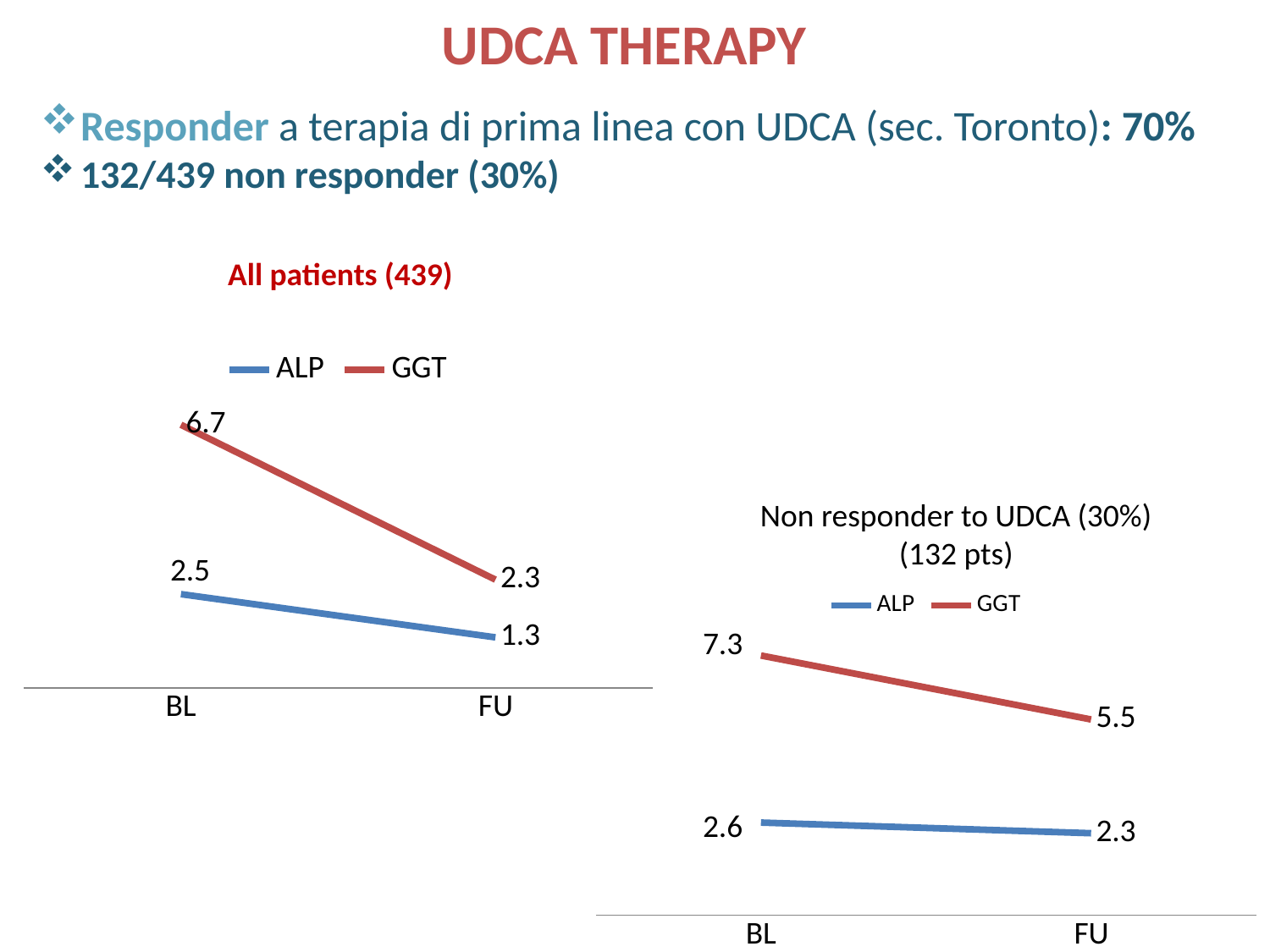
In the 'All patients (439)' chart, what is the GGT value at BL? 6.7 In the 'All patients (439)' chart, which series has the higher value at BL, ALP or GGT? GGT In the 'Non responder to UDCA (30%) (132 pts)' chart, what is the GGT value at FU? 5.5 In the 'All patients (439)' chart, does the GGT series rise or fall from BL to FU? fall What kind of chart is the 'All patients (439)' chart? line chart In the 'Non responder to UDCA (30%) (132 pts)' chart, what is the difference between the GGT values at BL and FU? 1.8 How many categories are on the x axis of the 'Non responder to UDCA (30%) (132 pts)' chart? 2 In the 'All patients (439)' chart, what is the difference between the GGT values at BL and FU? 4.4 How many series does the legend of the 'All patients (439)' chart list? 2 In the 'Non responder to UDCA (30%) (132 pts)' chart, does the ALP series rise or fall from BL to FU? fall In the 'Non responder to UDCA (30%) (132 pts)' chart, what is the ALP value at BL? 2.6 In the 'All patients (439)' chart, what is the ALP value at FU? 1.3